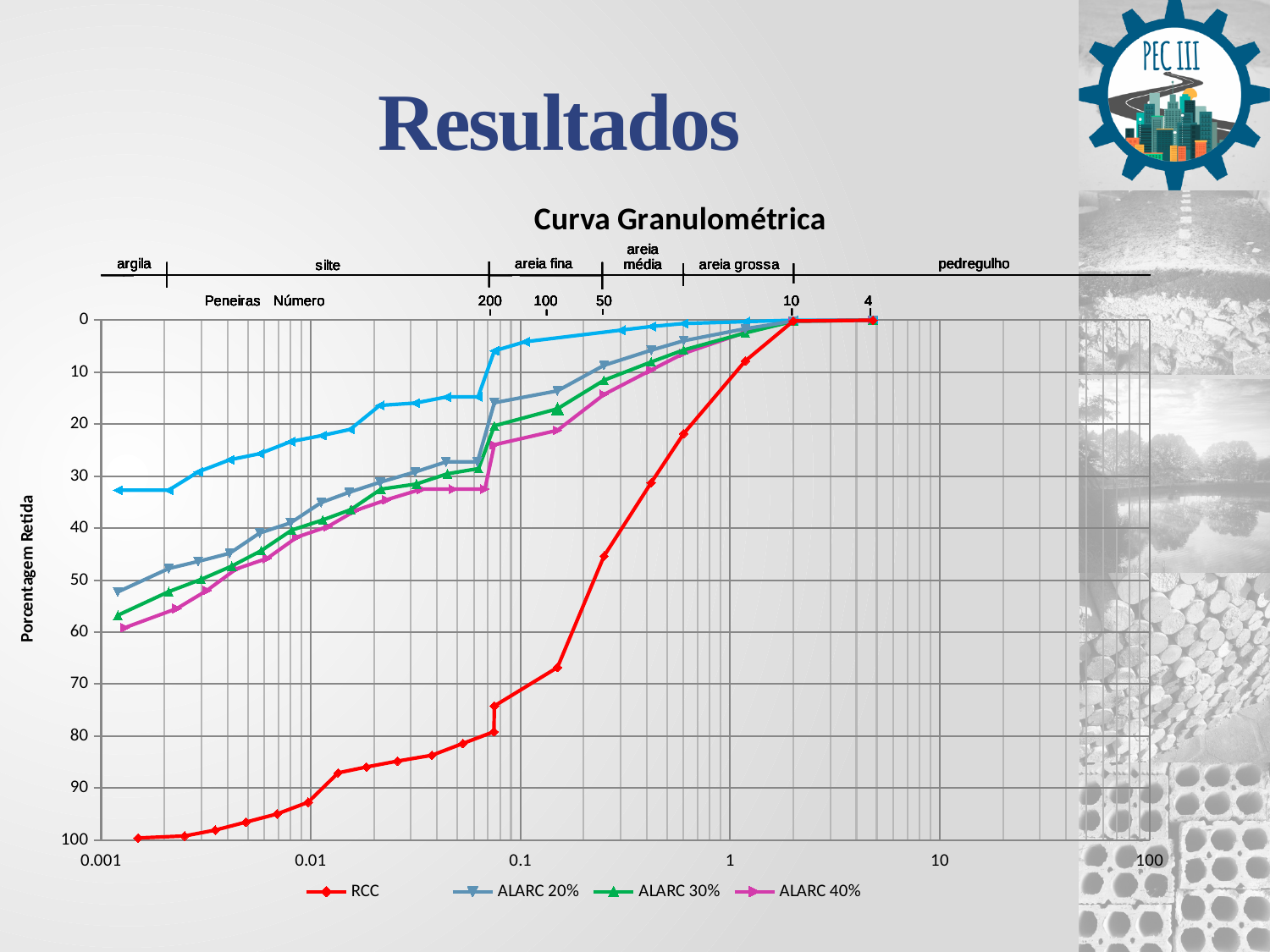
What is the title of the chart? Curva Granulométrica Is the value for RCC at 0.01 greater or less than 90? greater How many series does the chart legend list? 4 What is the label of the vertical axis? Porcentagem Retida At 0.001, which series has the higher value, RCC or ALARC 40%? RCC Among the series in the legend, which has the highest value at 0.001? RCC Do the values of the RCC series rise or fall as the x axis increases? fall What kind of chart is shown on the slide? line chart